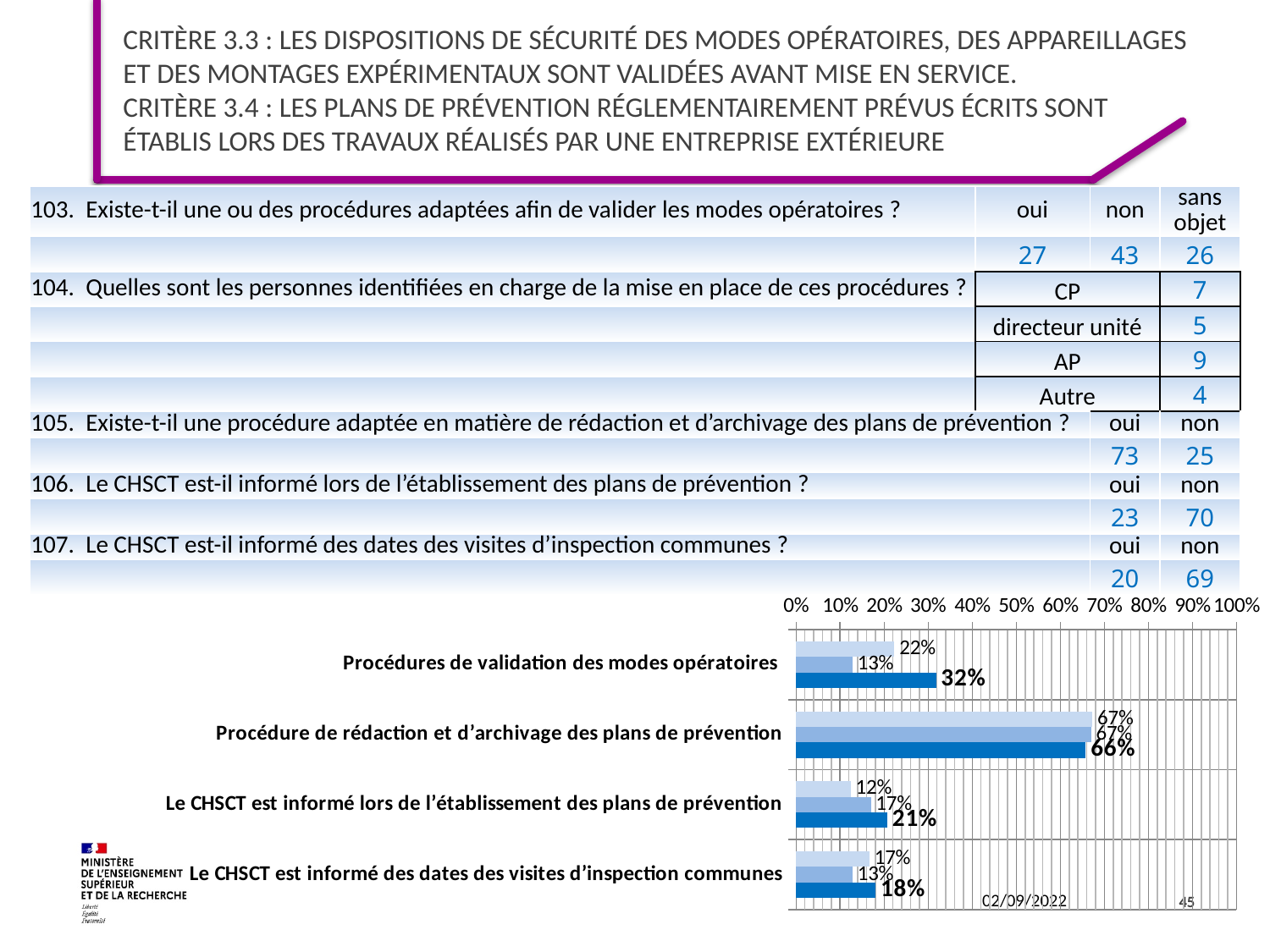
What is the maximum value shown on the percentage axis of the bar chart? 100% In the bar chart, what is the value of the dark blue (bottom) bar for 'Procédure de rédaction et d'archivage des plans de prévention'? 66% In the bar chart, what is the value of the light blue (top) bar for 'Procédures de validation des modes opératoires'? 22% How many categories does the bar chart show? 4 In the bar chart, is the dark blue bar for 'Procédure de rédaction et d'archivage des plans de prévention' greater or less than 50%? greater What kind of chart is shown at the bottom of the slide? bar chart In the bar chart, what is the value of the dark blue (bottom) bar for 'Le CHSCT est informé des dates des visites d'inspection communes'? 18% In the bar chart, what is the value of the dark blue (bottom) bar for 'Le CHSCT est informé lors de l'établissement des plans de prévention'? 21% In the bar chart, what is the difference between the dark blue bar values for 'Procédures de validation des modes opératoires' (32%) and 'Le CHSCT est informé lors de l'établissement des plans de prévention' (21%)? 11% In the bar chart, which is larger: the dark blue bar for 'Procédures de validation des modes opératoires' or the dark blue bar for 'Le CHSCT est informé des dates des visites d'inspection communes'? Procédures de validation des modes opératoires In the bar chart, what is the value of the dark blue (bottom) bar for 'Procédures de validation des modes opératoires'? 32% Which category in the bar chart has the highest values? Procédure de rédaction et d'archivage des plans de prévention